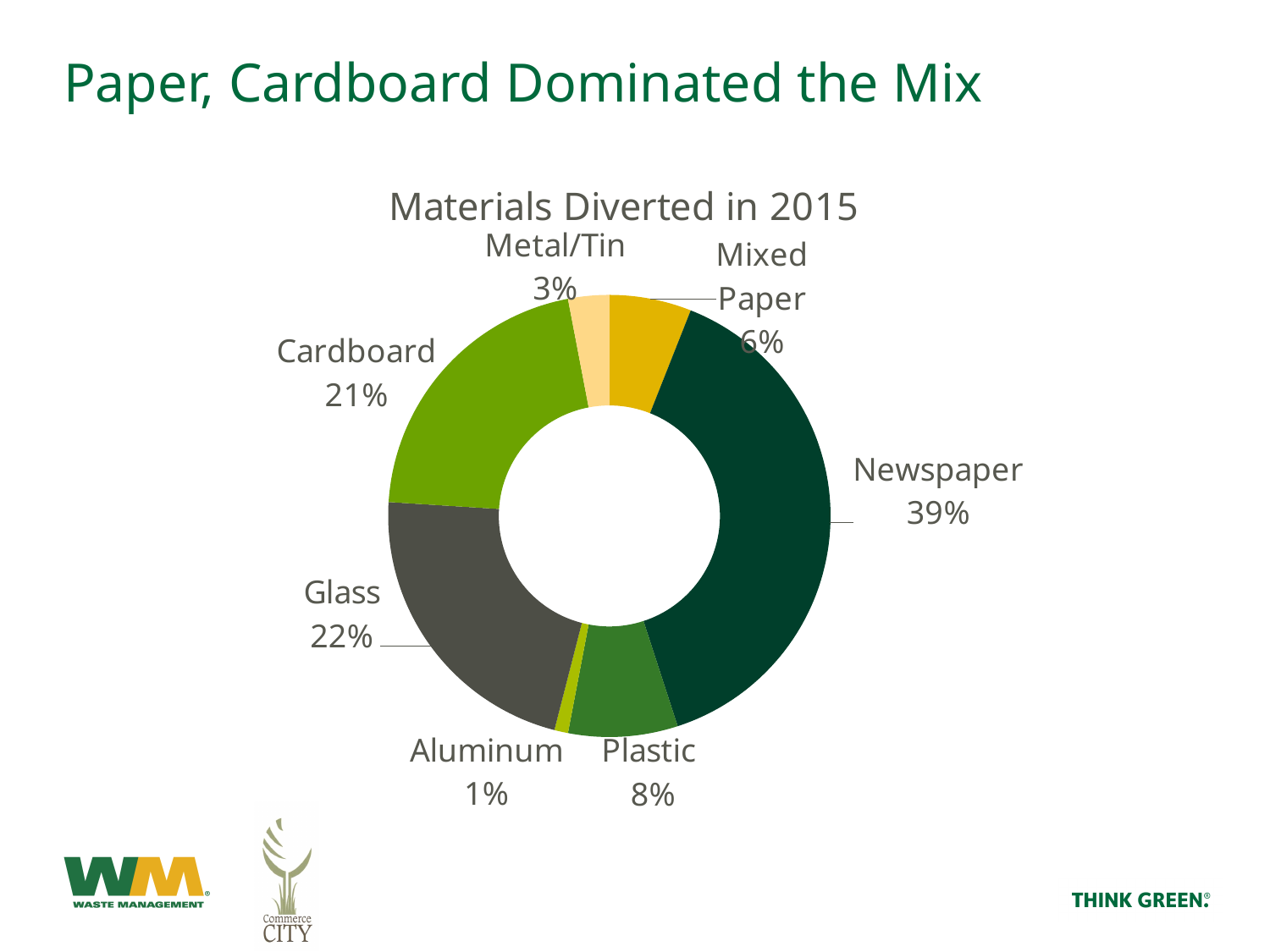
What is the title of the chart? Materials Diverted in 2015 What share of materials diverted in 2015 was Metal/Tin? 3% Which material has the smallest share of the materials diverted in 2015? Aluminum What share of materials diverted in 2015 was Glass? 22% What share of materials diverted in 2015 was Newspaper? 39% What share of materials diverted in 2015 was Cardboard? 21% How many material categories are shown in the chart? 7 What share of materials diverted in 2015 was Plastic? 8% How many percentage points larger is the Newspaper share than the Cardboard share? 18 Which has a larger share, Mixed Paper or Plastic? Plastic Which material has the largest share of the materials diverted in 2015? Newspaper What kind of chart is shown on the slide? Pie chart (doughnut)